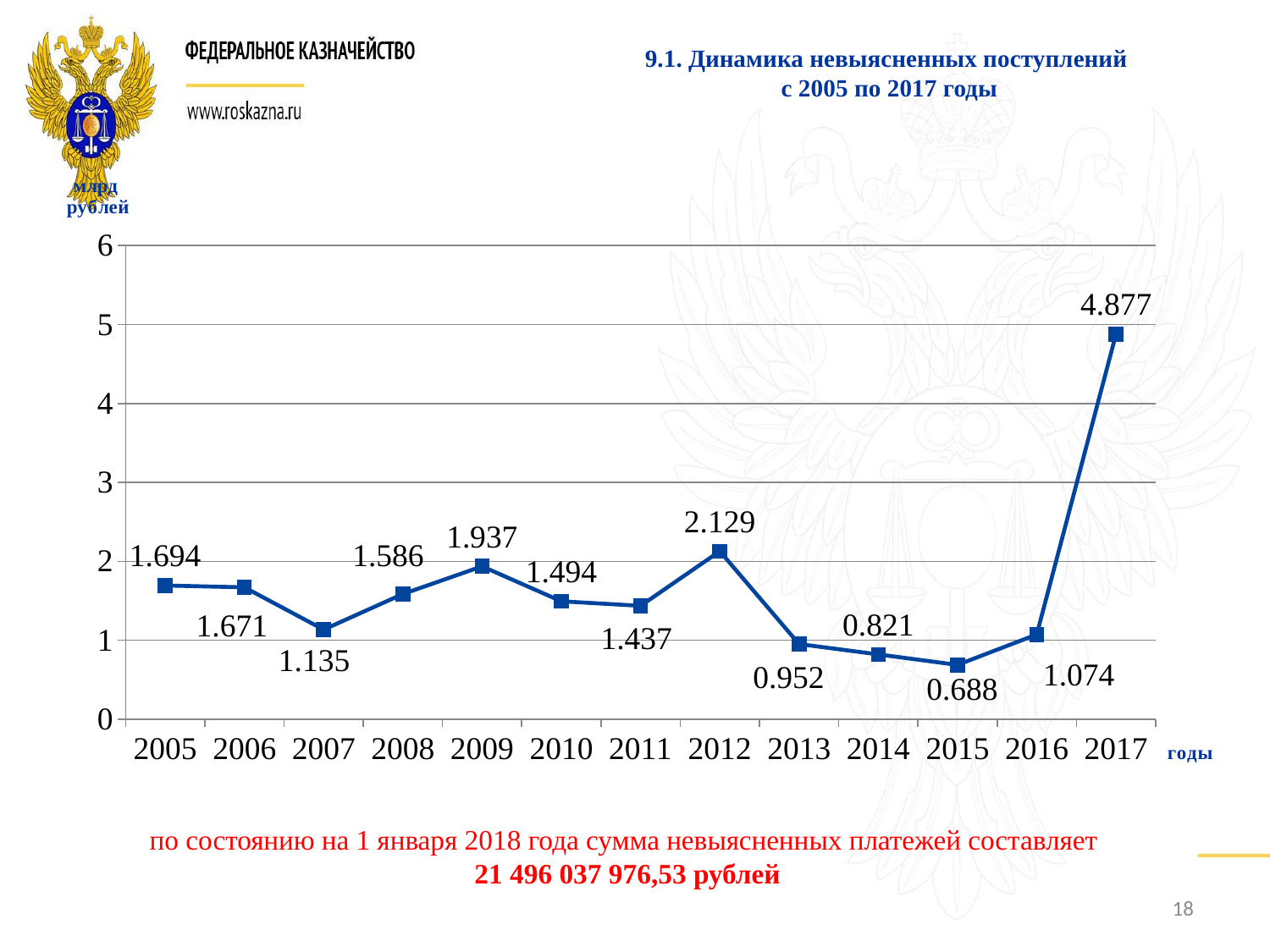
Which is larger, the value for 2009 or the value for 2010? 2009 What is the value for 2017? 4.877 What is the difference between the values for 2017 and 2016? 3.803 What kind of chart is shown on the slide? line chart Which year has the lowest value? 2015 What is the difference between the values for 2012 and 2013? 1.177 What is the value for 2012? 2.129 Which year has the highest value? 2017 What is the value for 2015? 0.688 What is the value for 2007? 1.135 Is the value for 2017 greater or less than 4? greater How many years are plotted on the chart? 13